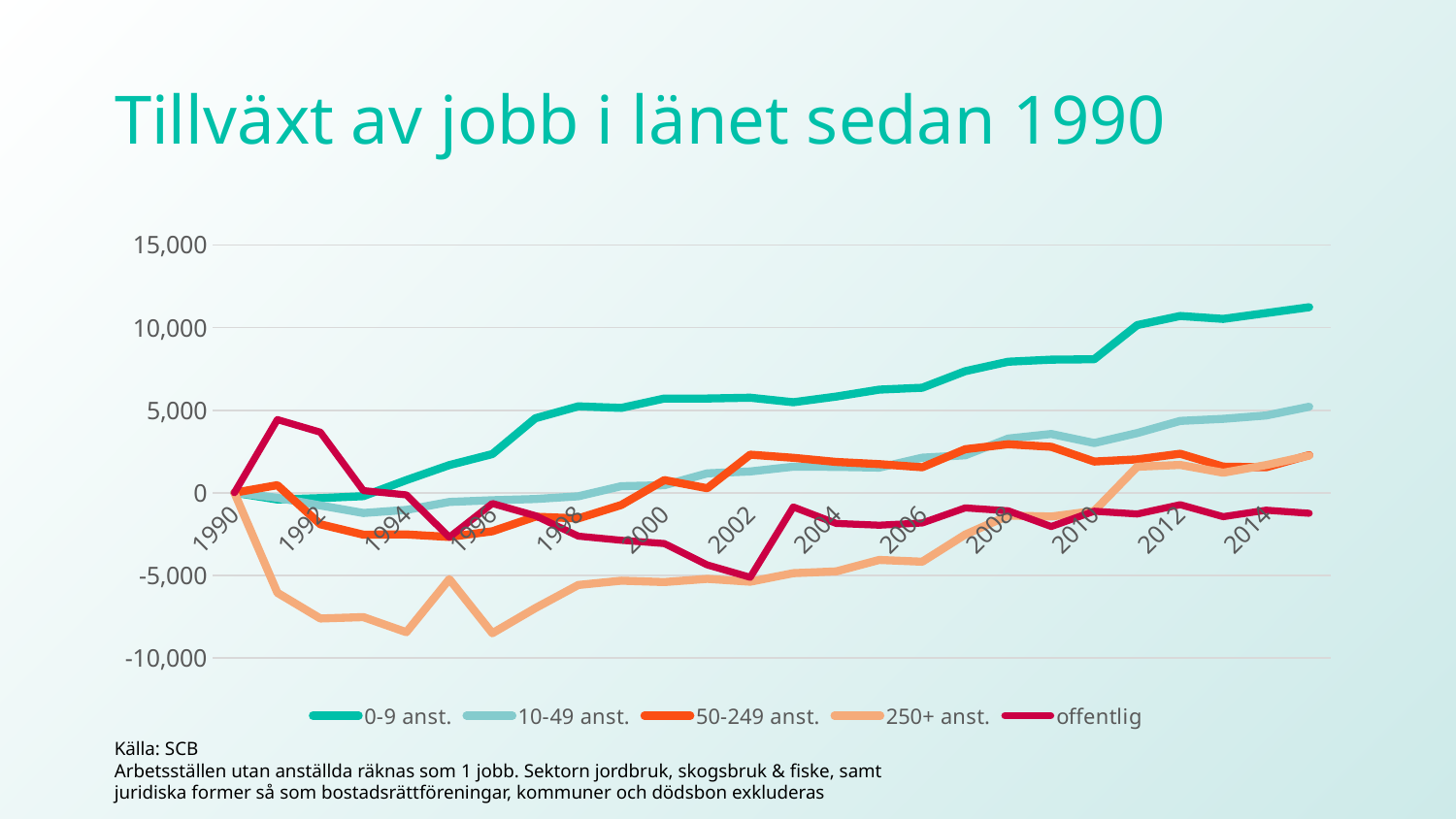
Is the value for 250+ anst. in 1996 greater or less than -5,000? less What kind of chart is shown on the slide? line chart Which series has the highest value in 2014? 0-9 anst. What is the title of the chart? Tillväxt av jobb i länet sedan 1990 Which series has the lowest value in 1996? 250+ anst. Does the 0-9 anst. series generally rise or fall from 1990 to 2014? rise Is the value for 0-9 anst. in 2014 greater or less than 10,000? greater How many series does the legend list? 5 Is the value for 10-49 anst. in 2008 greater or less than 5,000? less What source is cited below the chart? SCB In 2002, which is larger: the value for 0-9 anst. or the value for offentlig? 0-9 anst.